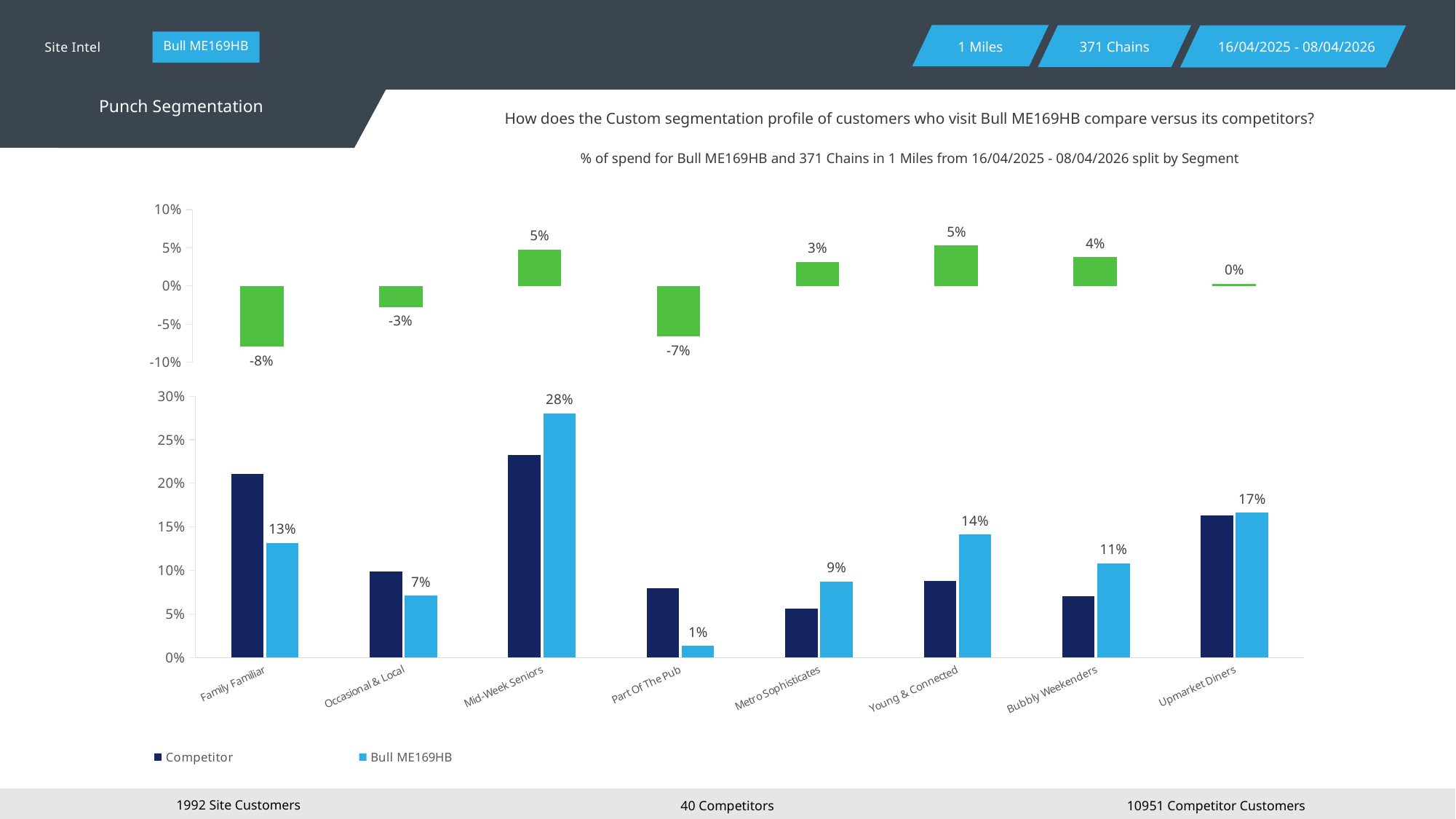
In the bottom chart, what is the difference between the Bull ME169HB values for Mid-Week Seniors and Family Familiar? 15% In the top chart, what is the value shown for Family Familiar? -8% In the bottom chart, which segment has the highest Bull ME169HB value? Mid-Week Seniors How many series does the legend of the bottom chart list? 2 In the bottom chart, is the Competitor value for Family Familiar greater or less than 20%? greater What kind of chart is the bottom chart? Bar chart In the bottom chart, what is the value for Bull ME169HB in the Mid-Week Seniors segment? 28% In the bottom chart, is the Competitor value for Metro Sophisticates greater or less than 10%? less In the bottom chart, which segment has the lowest Bull ME169HB value? Part Of The Pub How many segments are shown on the x axis of the bottom chart? 8 In the top chart, which segment has the lowest value? Family Familiar In the bottom chart, for Family Familiar, which is larger: the Competitor value or the Bull ME169HB value? Competitor